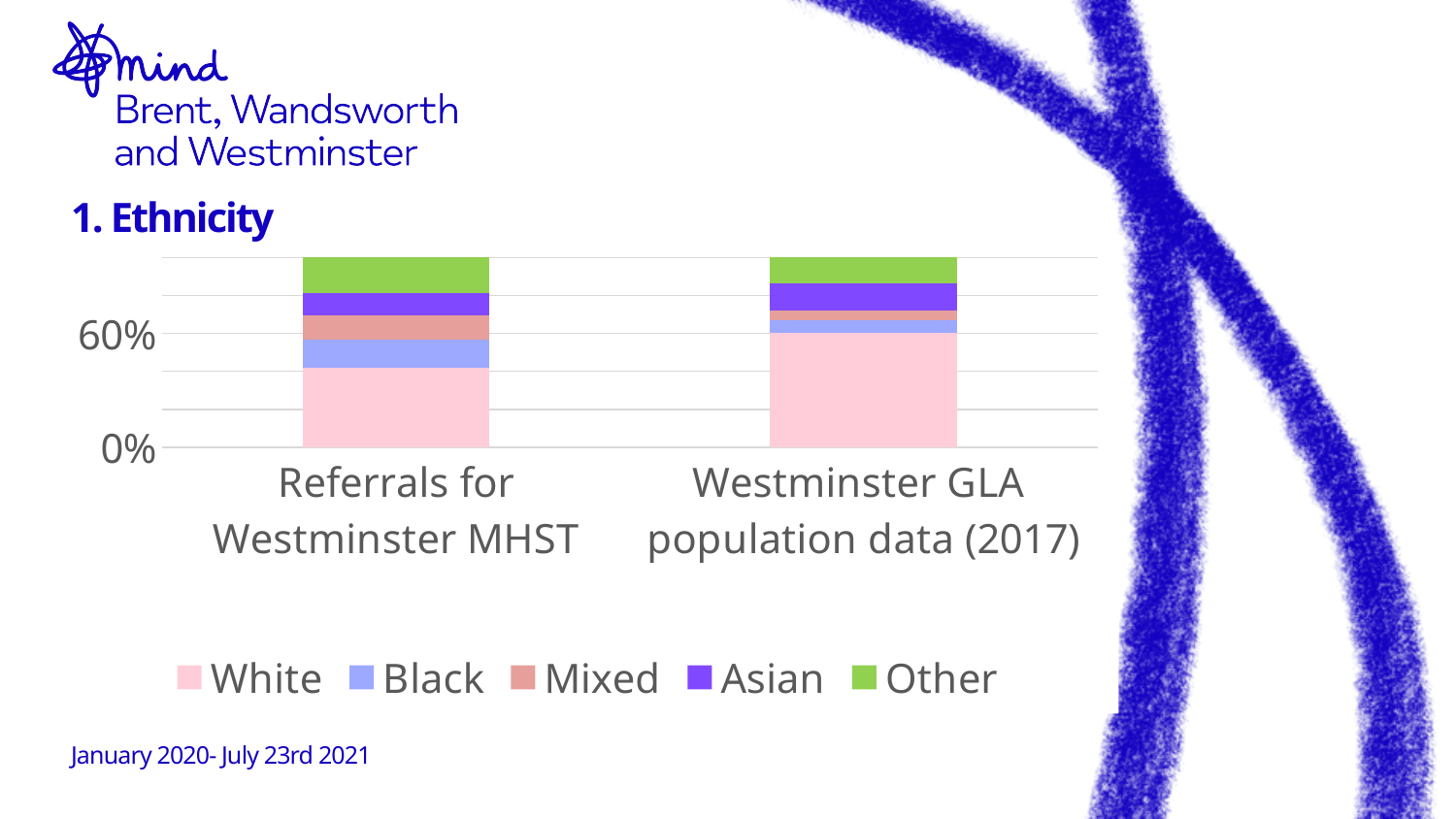
Which ethnicity series are listed in the chart legend? White, Black, Mixed, Asian, Other Which bar has the larger White segment: Referrals for Westminster MHST or Westminster GLA population data (2017)? Westminster GLA population data (2017) How many categories are shown on the x axis of the chart? 2 Which series makes up the largest segment of the Westminster GLA population data (2017) bar? White Which bar has the larger Black segment: Referrals for Westminster MHST or Westminster GLA population data (2017)? Referrals for Westminster MHST Is the White segment for Referrals for Westminster MHST greater or less than 20%? greater Which bar has the larger Mixed segment: Referrals for Westminster MHST or Westminster GLA population data (2017)? Referrals for Westminster MHST Which series makes up the largest segment of the Referrals for Westminster MHST bar? White What kind of chart is shown on the slide? Stacked bar chart What is the heading above the chart? 1. Ethnicity How many series does the chart legend list? 5 Is the White segment for Referrals for Westminster MHST greater or less than 60%? less